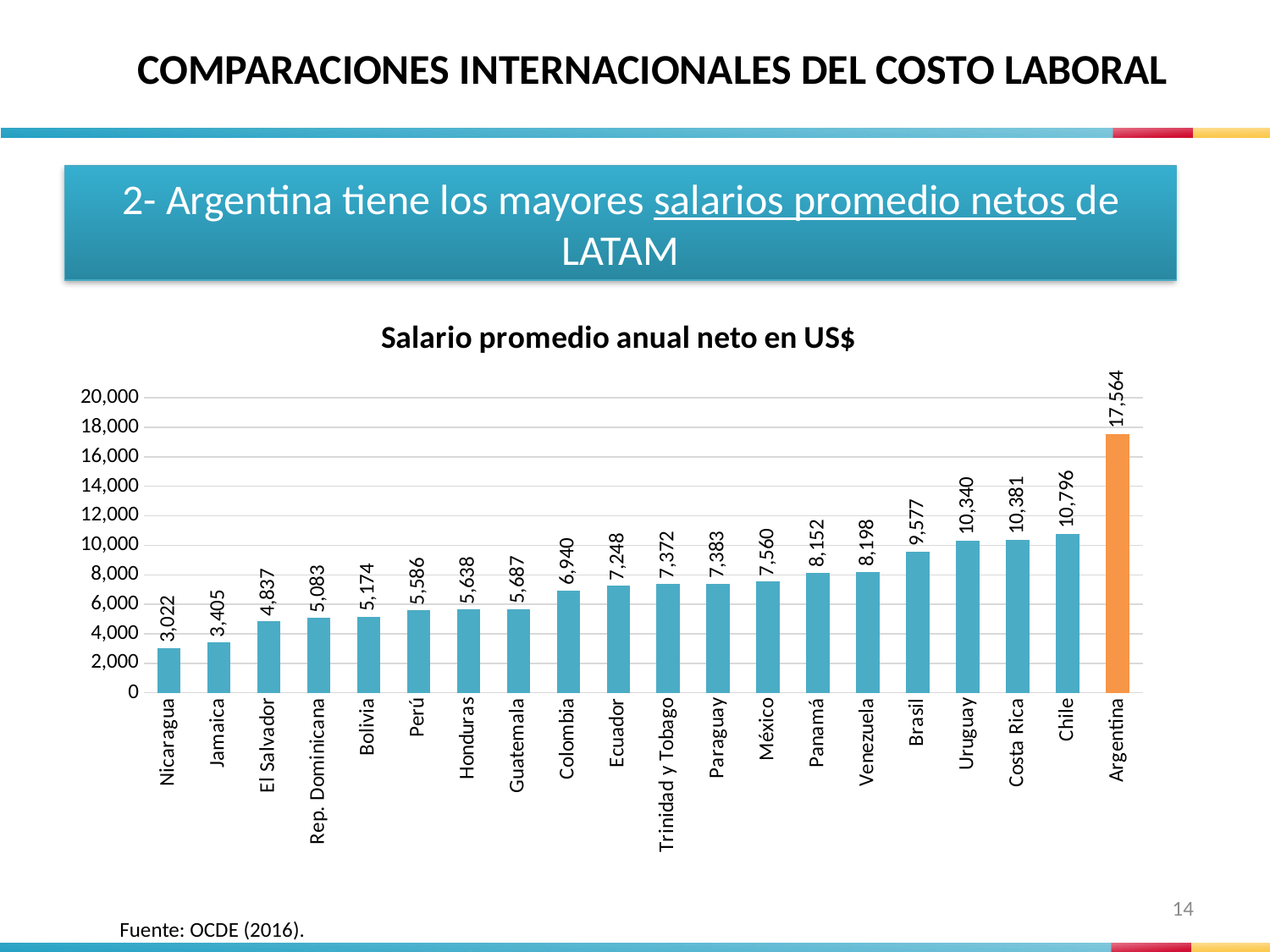
What is the value for Argentina in the chart? 17,564 What is the value for Uruguay in the chart? 10,340 What kind of chart is shown on the slide? bar chart Is the value for Chile greater or less than 10,000? greater What is the title of the chart? Salario promedio anual neto en US$ How many countries are shown in the chart? 20 Which country has the highest value in the chart? Argentina What is the value for Nicaragua in the chart? 3,022 What is the difference between the values for Argentina and Chile? 6,768 Which country has the lowest value in the chart? Nicaragua Do the values rise or fall from left to right along the x axis? rise Which has a larger value, Brasil or Panamá? Brasil